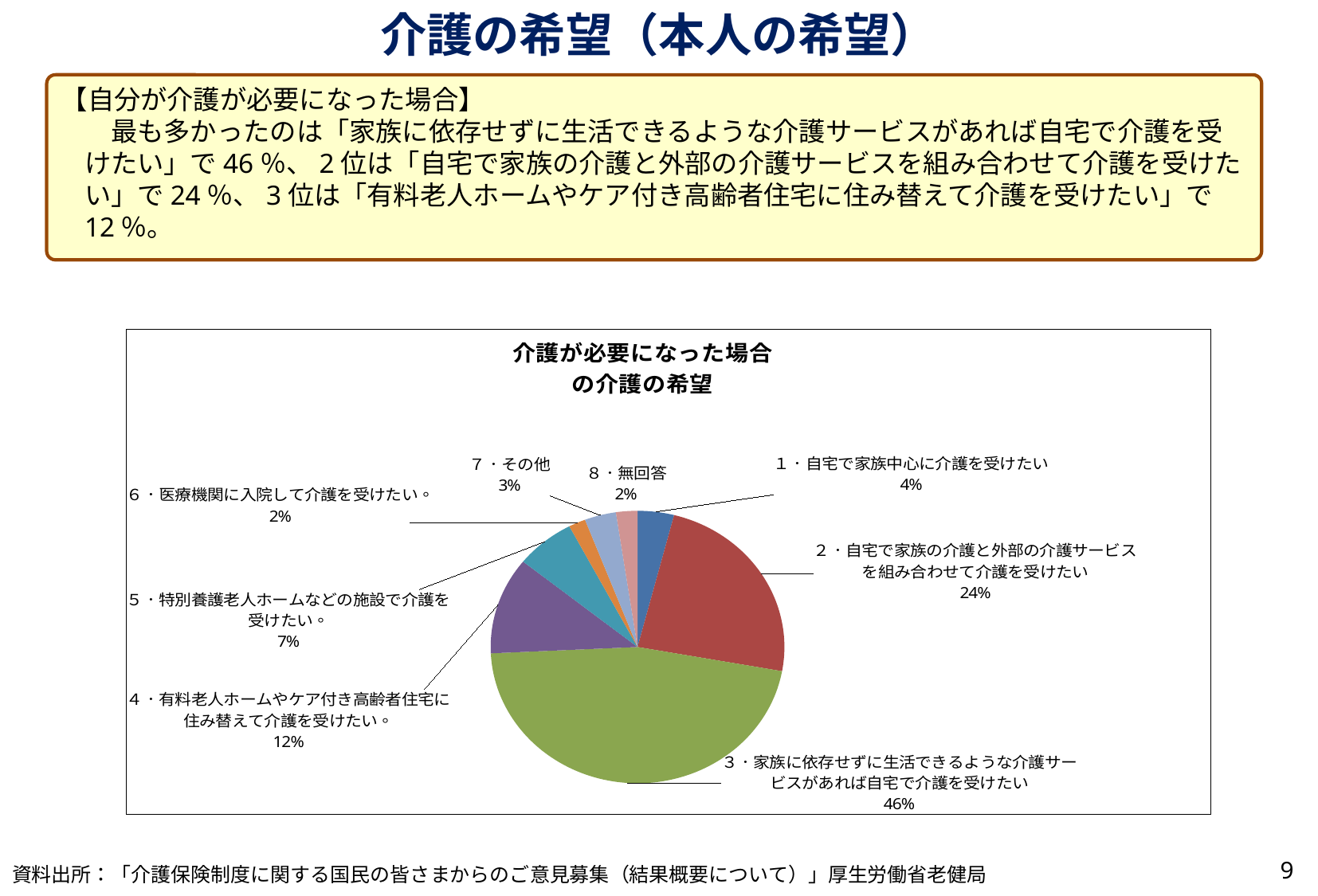
What is the difference in percentage points between "3・家族に依存せずに生活できるような介護サービスがあれば自宅で介護を受けたい" and "2・自宅で家族の介護と外部の介護サービスを組み合わせて介護を受けたい"? 22 What percentage is shown for "2・自宅で家族の介護と外部の介護サービスを組み合わせて介護を受けたい"? 24% What percentage is shown for "7・その他"? 3% Which is larger: the share for "4・有料老人ホームやケア付き高齢者住宅に住み替えて介護を受けたい。" or for "5・特別養護老人ホームなどの施設で介護を受けたい。"? 4・有料老人ホームやケア付き高齢者住宅に住み替えて介護を受けたい。 Which category has the largest share of the pie? 3・家族に依存せずに生活できるような介護サービスがあれば自宅で介護を受けたい What share of the pie does "8・無回答" represent? 2% How many slices does the pie chart have? 8 What percentage is shown for "1・自宅で家族中心に介護を受けたい"? 4% What percentage is shown for "3・家族に依存せずに生活できるような介護サービスがあれば自宅で介護を受けたい"? 46% What type of chart is shown on the slide? pie chart What is the title of the chart? 介護が必要になった場合の介護の希望 What percentage is shown for "5・特別養護老人ホームなどの施設で介護を受けたい。"? 7%